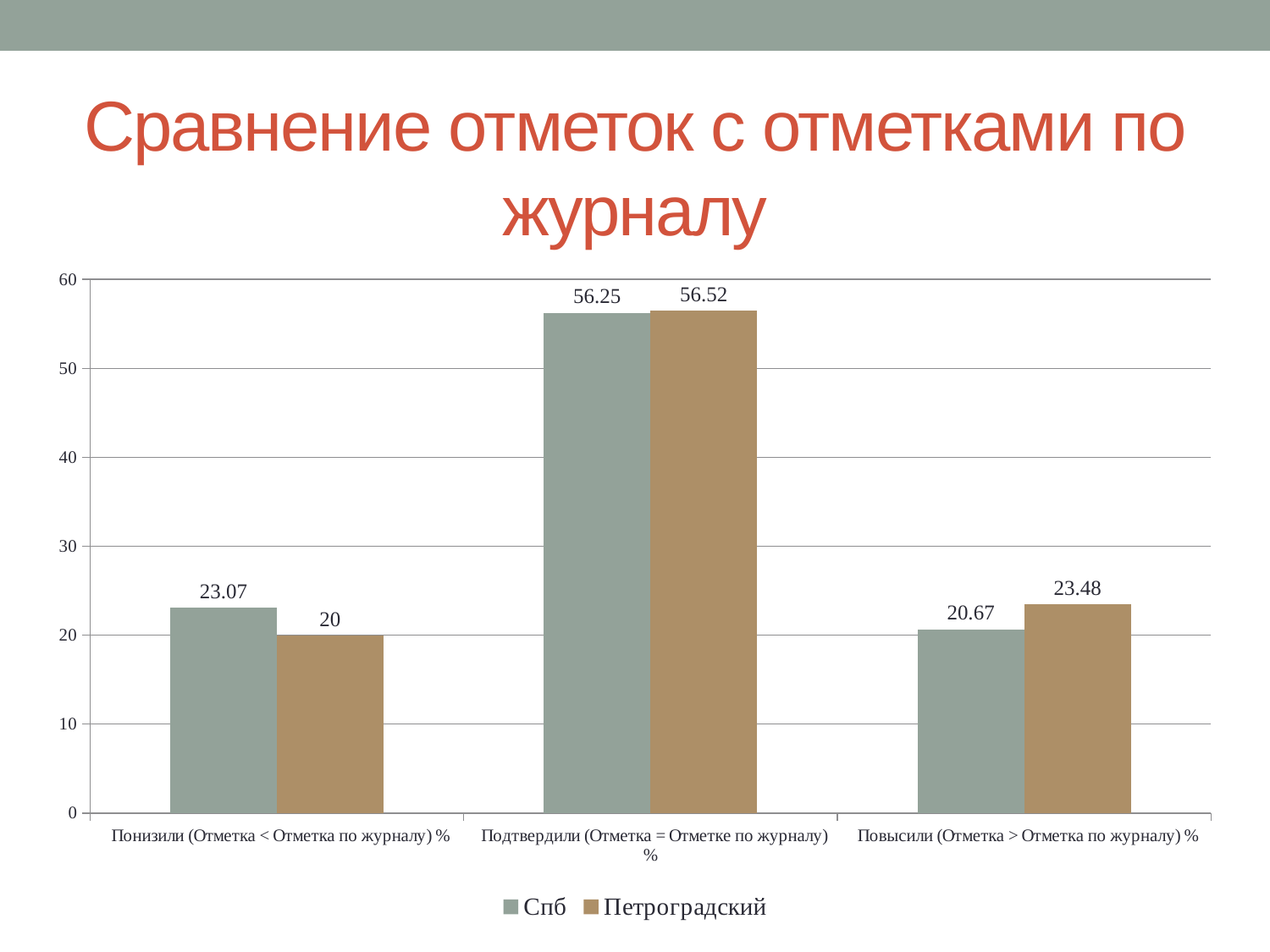
What is the title of the slide? Сравнение отметок с отметками по журналу How many series does the legend list? 2 How many categories are shown on the x axis? 3 What is the value for Спб in the category 'Повысили (Отметка > Отметка по журналу) %'? 20.67 In the category 'Повысили (Отметка > Отметка по журналу) %', which series has the larger value, Спб or Петроградский? Петроградский Which category has the highest value for Спб? Подтвердили (Отметка = Отметке по журналу) % What type of chart is shown on the slide? bar chart Which category has the lowest value for Петроградский? Понизили (Отметка < Отметка по журналу) % What is the value for Петроградский in the category 'Повысили (Отметка > Отметка по журналу) %'? 23.48 What is the difference between the Спб and Петроградский values in the category 'Понизили (Отметка < Отметка по журналу) %'? 3.07 What is the value for Спб in the category 'Понизили (Отметка < Отметка по журналу) %'? 23.07 What is the value for Петроградский in the category 'Подтвердили (Отметка = Отметке по журналу) %'? 56.52